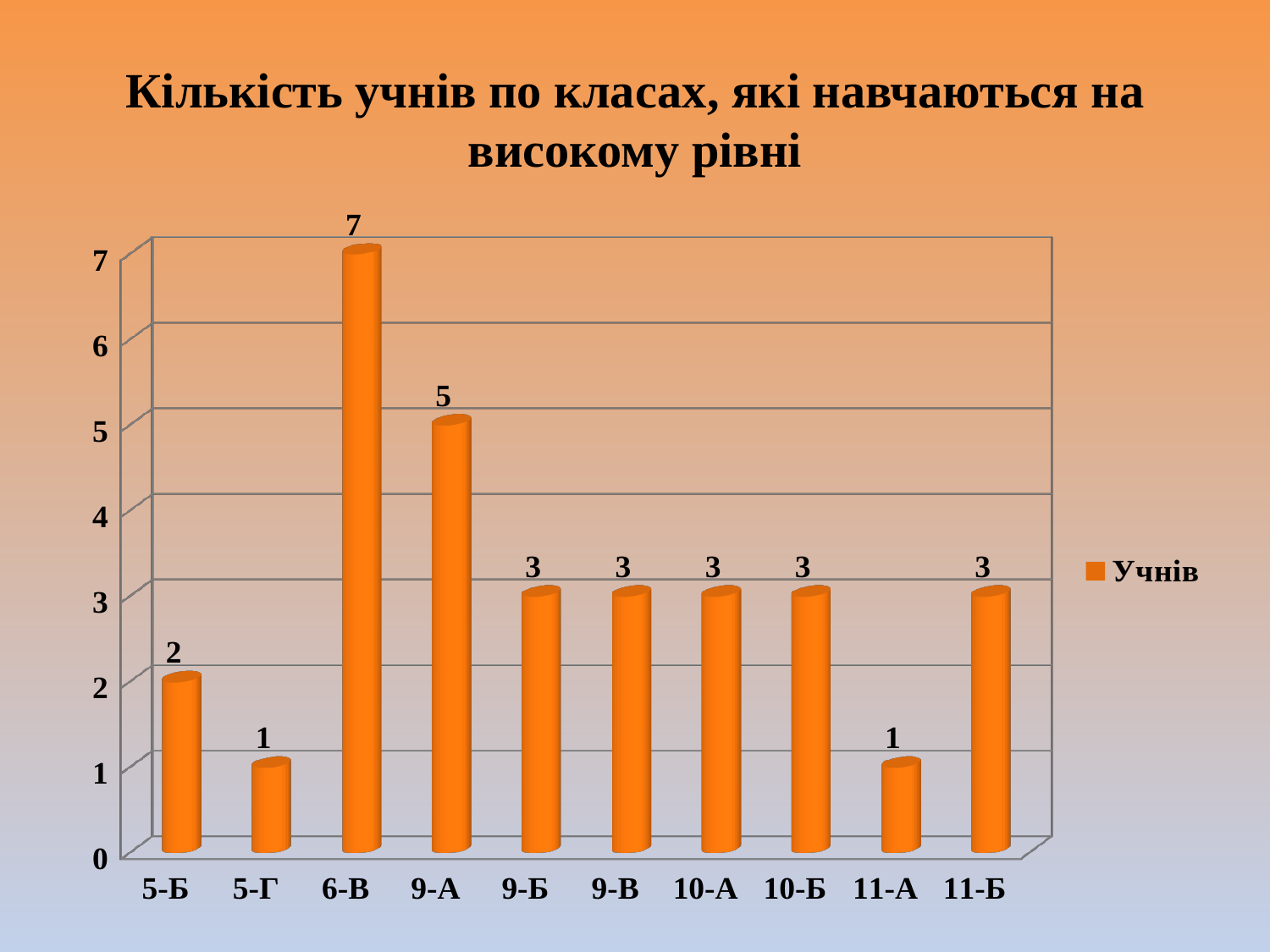
How many classes are shown on the x axis? 10 What is the legend entry for the series? Учнів What is the value for class 6-В? 7 What is the difference between the values for 6-В and 9-А? 2 What is the value for class 9-А? 5 Which is larger, the value for 5-Б or the value for 5-Г? 5-Б How many classes have a value of 3? 5 How many series does the legend list? 1 What is the value for class 5-Б? 2 Which class has the highest value? 6-В What kind of chart is this? bar chart What is the difference between the values for 11-Б and 11-А? 2